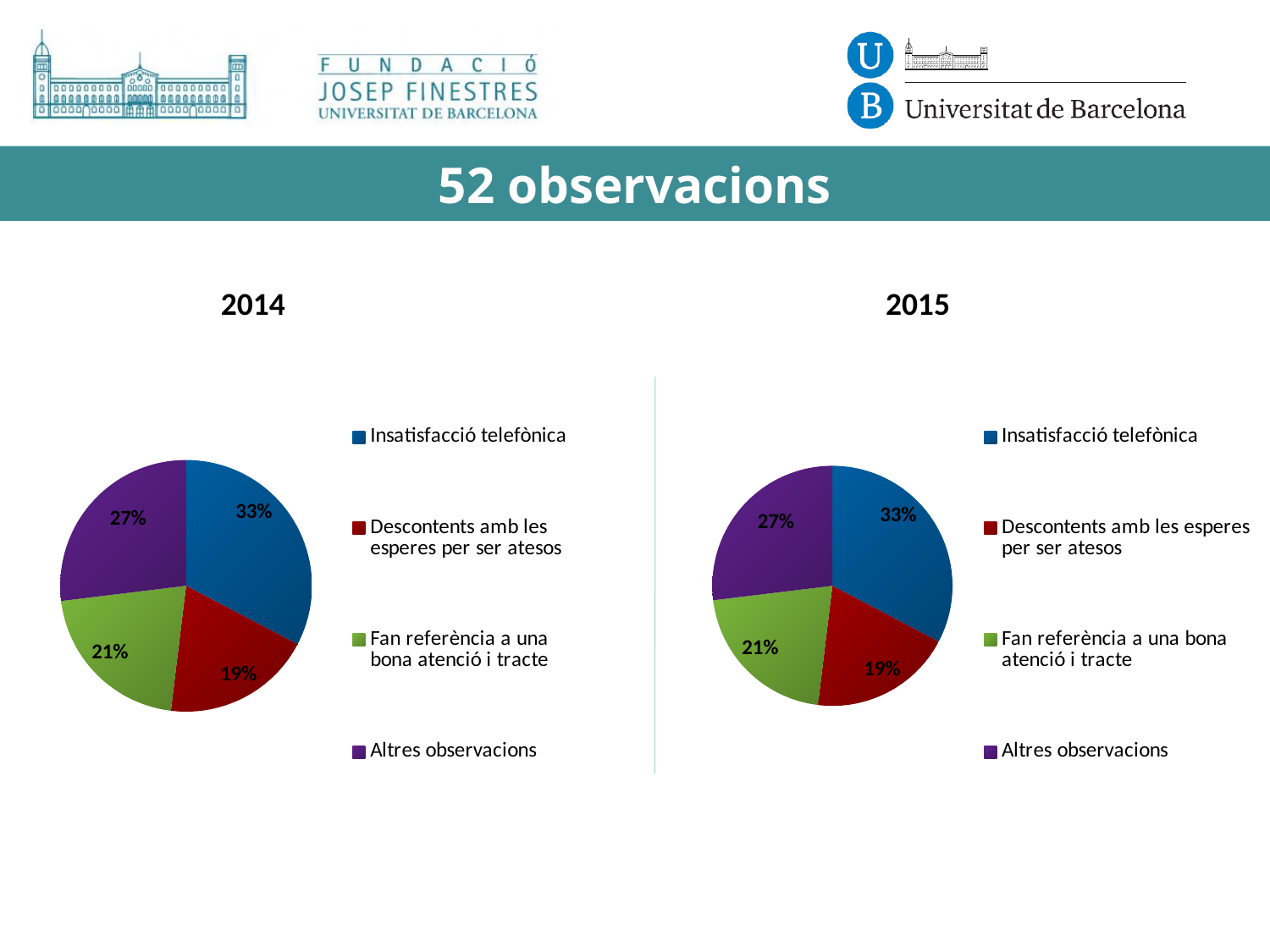
What is the title shown in the banner above the two charts? 52 observacions What type of chart is the 2015 chart? Pie chart In the 2015 pie chart, which category has the smallest share? Descontents amb les esperes per ser atesos How many slices does the 2014 pie chart have? 4 In the 2015 pie chart, which is larger: Fan referència a una bona atenció i tracte or Descontents amb les esperes per ser atesos? Fan referència a una bona atenció i tracte In the 2015 pie chart, what is the value for Fan referència a una bona atenció i tracte? 21% In the 2014 pie chart, what is the difference between the shares of Insatisfacció telefònica and Altres observacions? 6% In the 2014 pie chart, what is the value for Descontents amb les esperes per ser atesos? 19% In the 2015 pie chart, what colour is the Altres observacions slice? Purple In the 2014 pie chart, what share does Insatisfacció telefònica have? 33% In the 2015 pie chart, what share does Altres observacions have? 27% In the 2014 pie chart, which category has the largest share? Insatisfacció telefònica